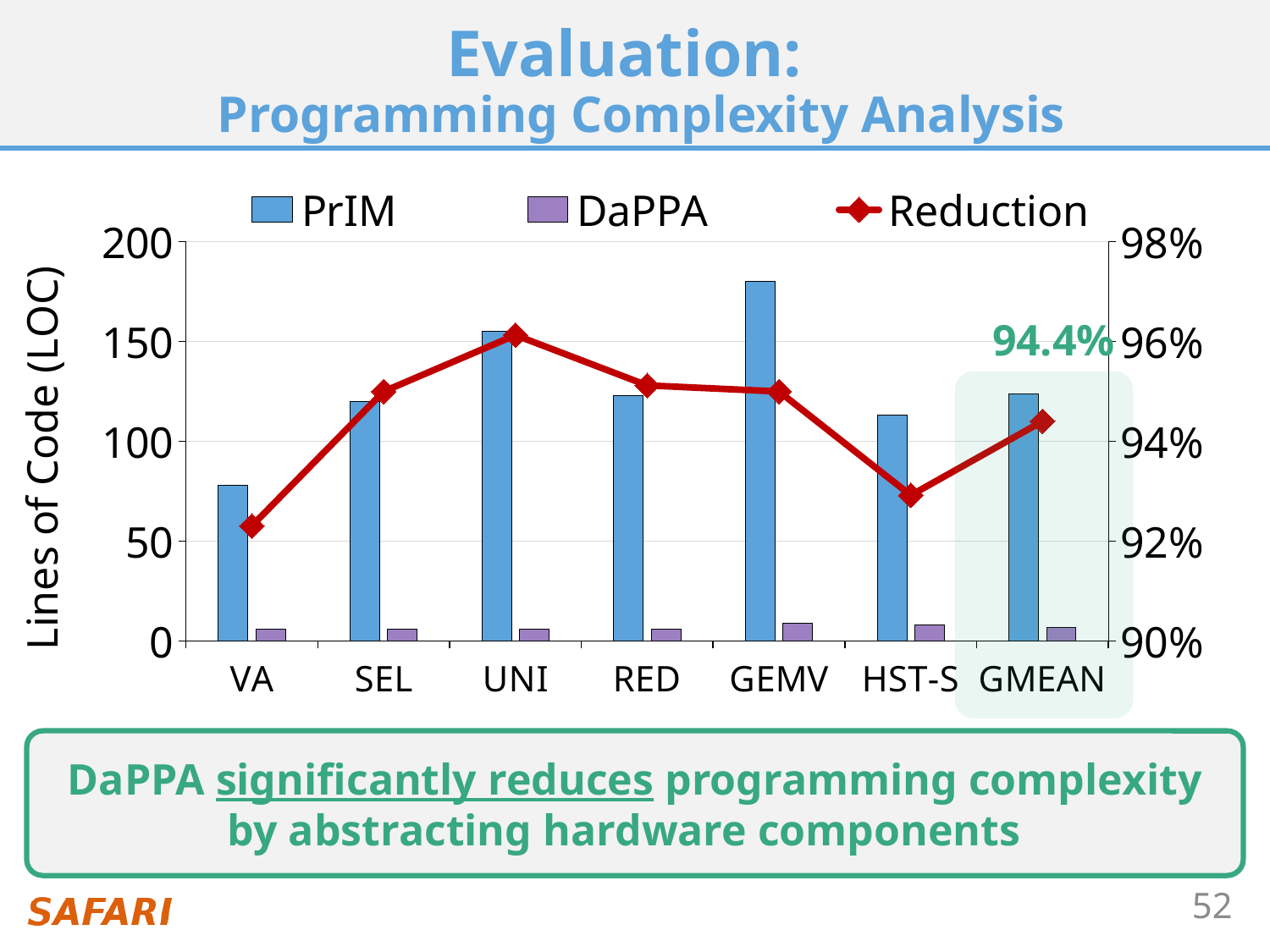
Which category has the highest PrIM lines of code? GEMV What is the title of the left vertical axis? Lines of Code (LOC) What kind of chart is shown on the slide? bar and line chart Is the Reduction value for VA greater or less than 94%? less Is the PrIM value for VA greater or less than 100? less How many series does the legend list? 3 How many categories are shown on the x axis? 7 Which has more PrIM lines of code, GEMV or UNI? GEMV What is the Reduction value shown for GMEAN? 94.4% Which category has the highest Reduction percentage? UNI Which category has the lowest PrIM lines of code? VA Is the PrIM value for GEMV greater or less than 150? greater